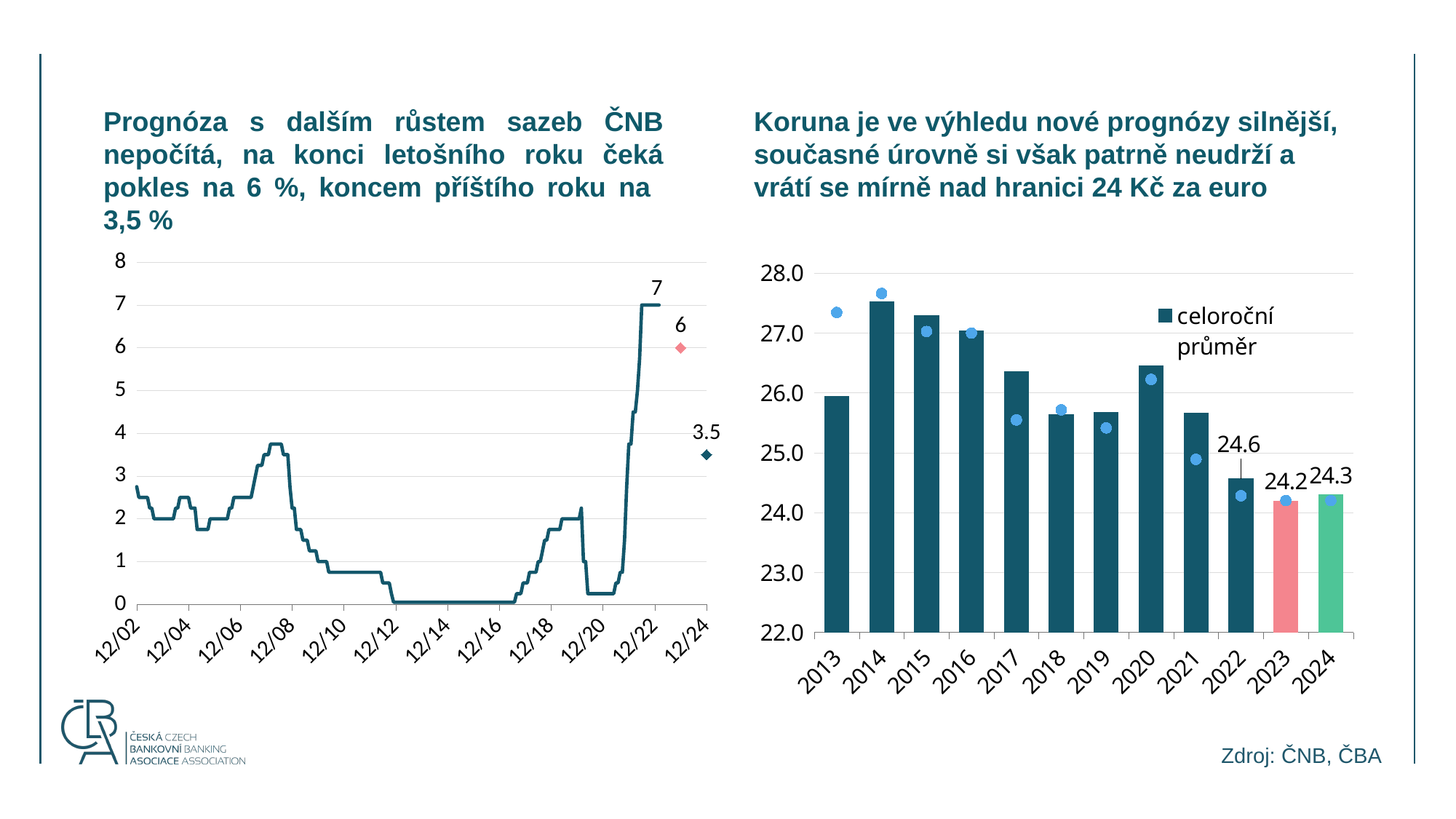
On the right-hand bar chart, which year has the highest bar? 2014 On the left-hand line chart, what is the value of the last labelled point near 12/24? 3.5 On the right-hand bar chart, what is the difference between the values for 2022 and 2023? 0.4 On the right-hand bar chart, what is the value shown for 2022? 24.6 On the right-hand bar chart, what is the value shown for 2024? 24.3 On the right-hand bar chart, how many years are shown on the x axis? 12 On the right-hand bar chart, what is the legend entry for the bars? celoroční průměr What kind of chart is the left-hand chart? line chart On the left-hand line chart, what is the highest labelled value reached by the line? 7 On the right-hand bar chart, which year has the lowest bar? 2023 On the right-hand bar chart, what is the value shown for 2023? 24.2